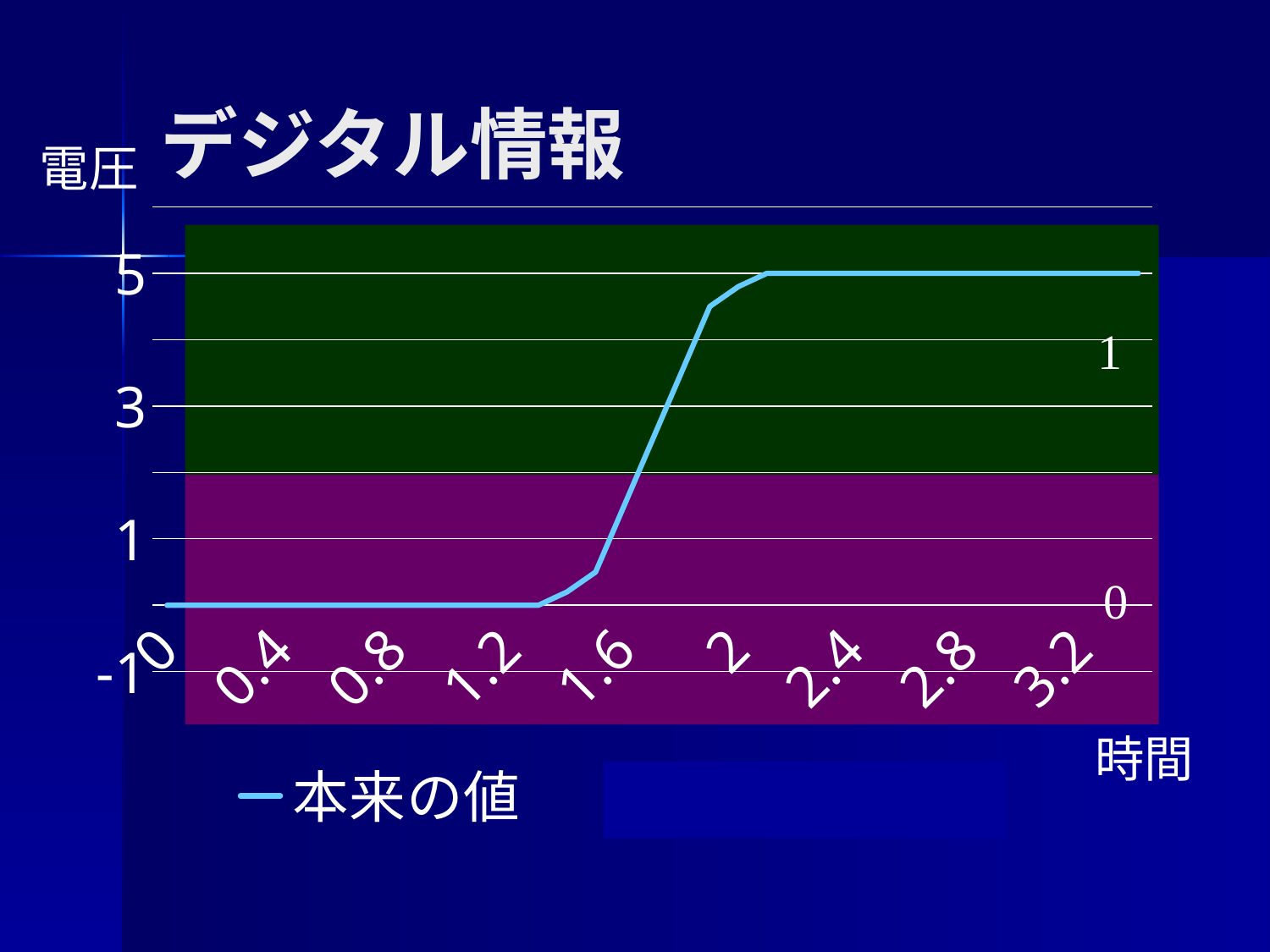
Is the value of 本来の値 at time 2.8 greater or less than 3? greater Is the value of 本来の値 at time 0.4 greater or less than 1? less Which is larger, the value of 本来の値 at time 0.8 or at time 2.8? 2.8 What is the title of the chart? デジタル情報 How many tick labels are shown on the x axis? 9 How many series does the legend list? 1 Is the value of 本来の値 at time 2.4 greater or less than 3? greater What kind of chart is shown on the slide? line chart What is the name of the series shown in the legend? 本来の値 Does the value of 本来の値 rise or fall as time increases from 1.2 to 2.4? rise What is the value of 本来の値 at time 3.2? 5